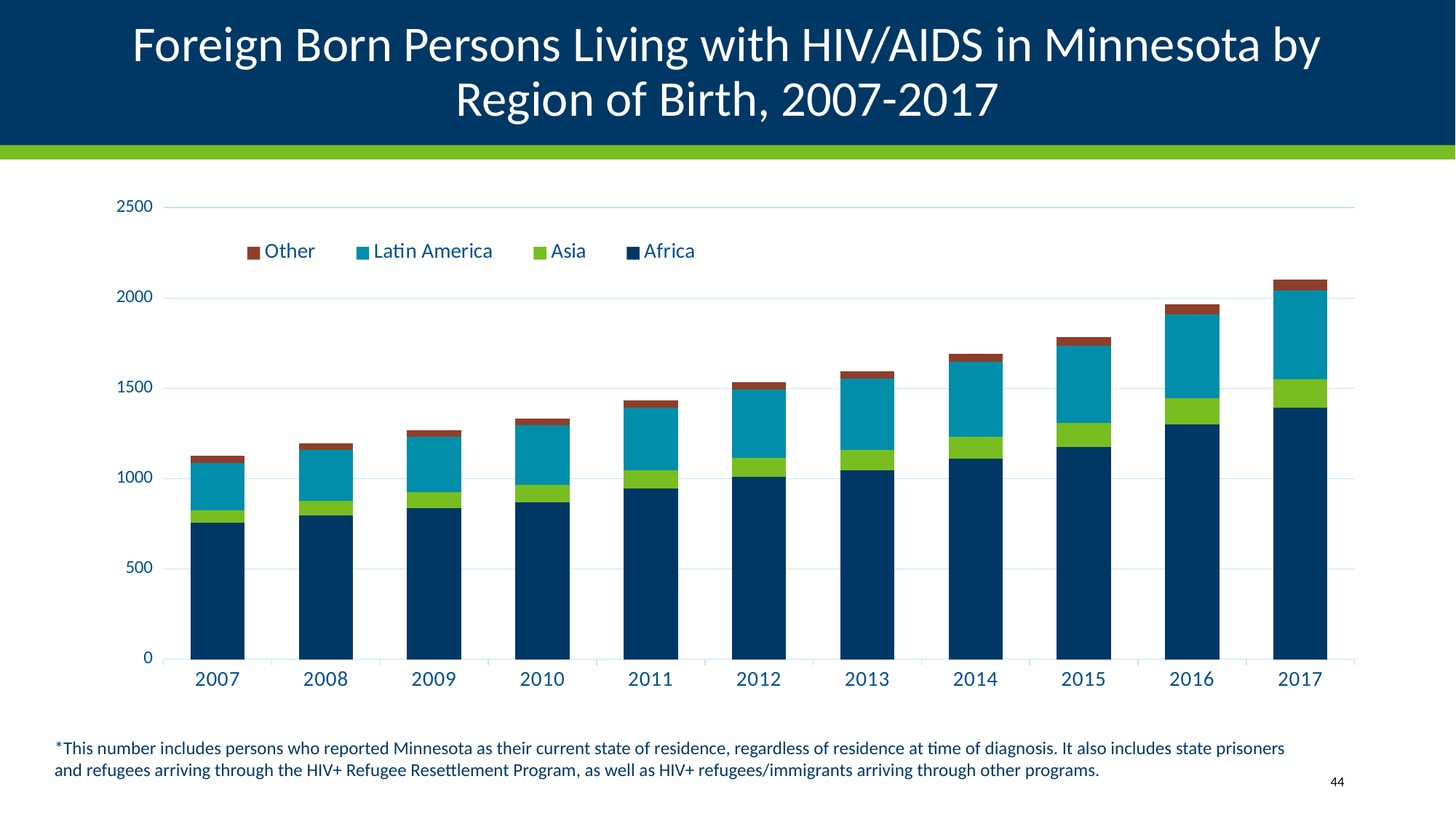
Which year has the lowest total number of foreign born persons living with HIV/AIDS? 2007 Is the total for 2007 greater or less than 1000? greater How many series does the legend list? 4 Which region of birth is shown in dark blue in the legend? Africa Is the Africa value for 2007 greater or less than 1000? less Is the Africa value for 2017 greater or less than 1000? greater Which year has the highest total number of foreign born persons living with HIV/AIDS? 2017 How many years are shown on the x axis? 11 What kind of chart is shown on the slide? Stacked bar chart Do the total bar heights rise or fall from 2007 to 2017? Rise